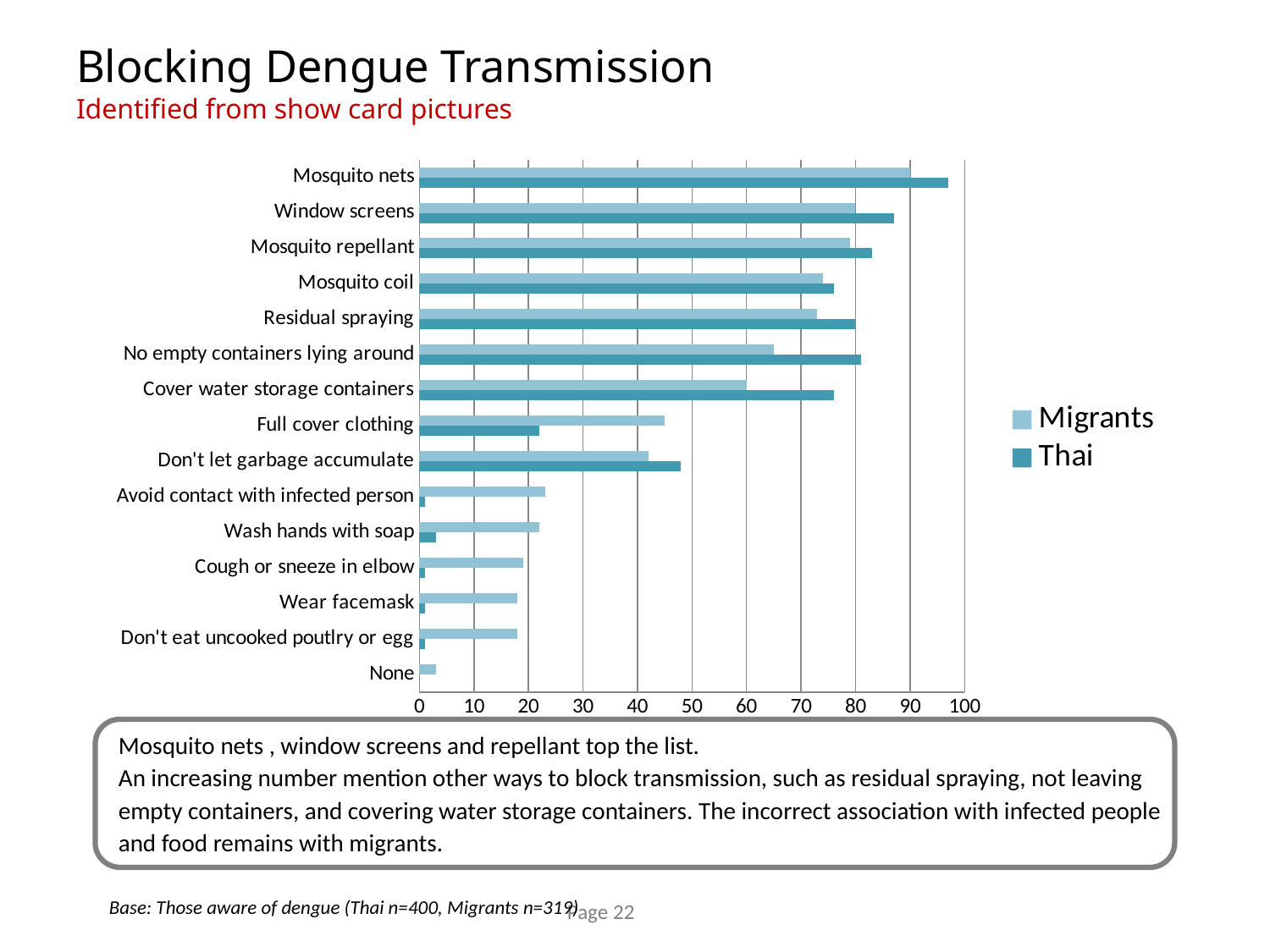
Which category has the lowest value for Migrants? None For No empty containers lying around, which is larger: Thai or Migrants? Thai Which category has the highest value for Thai? Mosquito nets What kind of chart is shown on the slide? bar chart Is the Migrants value for Cover water storage containers greater or less than 70? less How many categories are plotted on the chart? 15 Is the Thai value for Wash hands with soap greater or less than 10? less Which series is shown in the lighter blue colour? Migrants Which category has the highest value for Migrants? Mosquito nets Is the Migrants value for Mosquito nets greater or less than 80? greater How many series does the legend list? 2 For Full cover clothing, which is larger: Migrants or Thai? Migrants